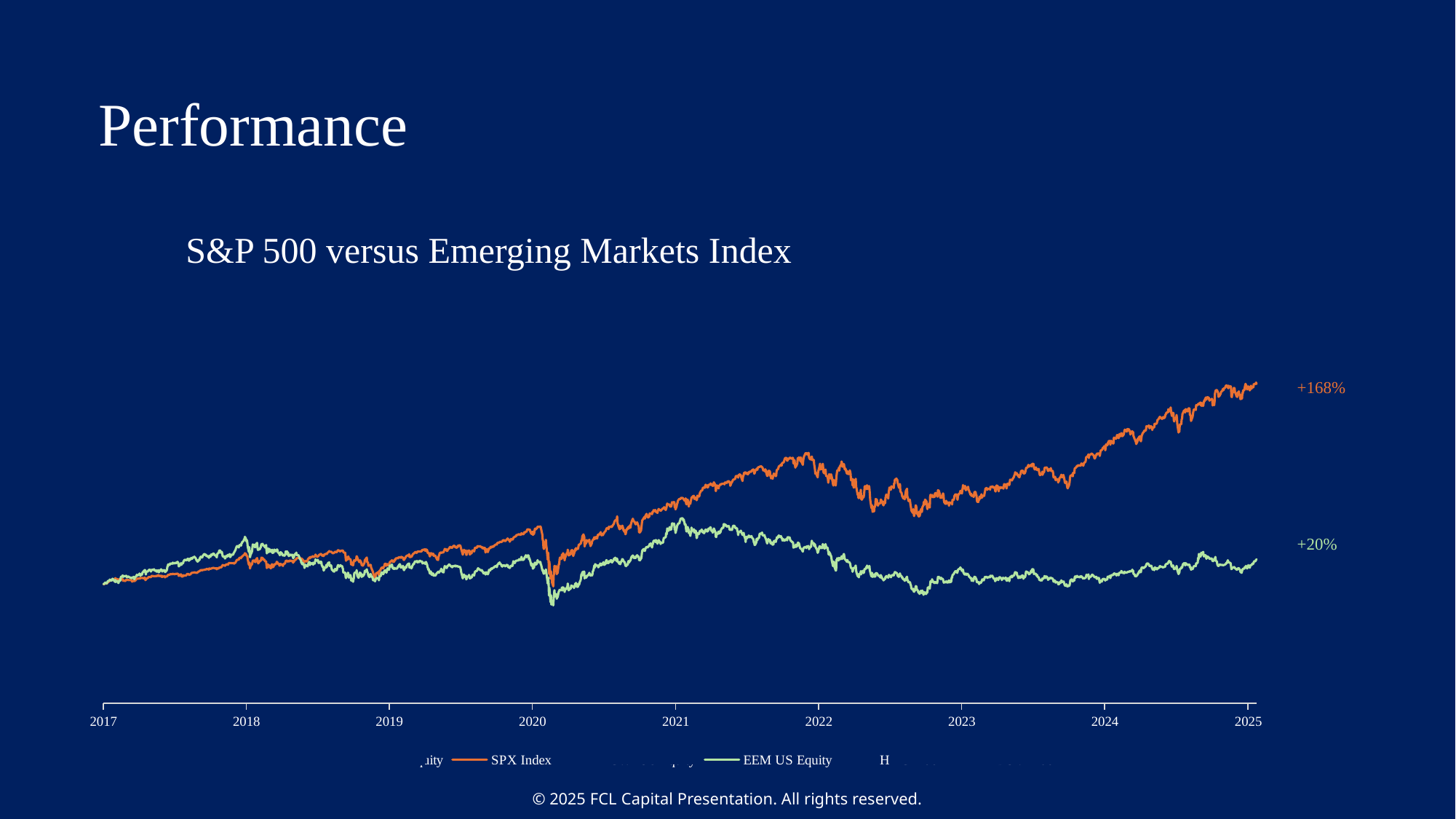
What is the difference between the labelled end values of SPX Index and EEM US Equity? 148 percentage points What cumulative return is labelled at the end of the EEM US Equity line? +20% What is the chart's title? S&P 500 versus Emerging Markets Index What is the last year shown on the x axis? 2025 What is the first year shown on the x axis? 2017 What cumulative return is labelled at the end of the SPX Index line? +168% Which series ends higher, SPX Index or EEM US Equity? SPX Index How many lines are plotted on the chart? 2 Which series has the lowest labelled end value? EEM US Equity Does the SPX Index line generally rise or fall from 2017 to 2025? rise What type of chart is shown on the slide? line chart What colour is the SPX Index line? orange